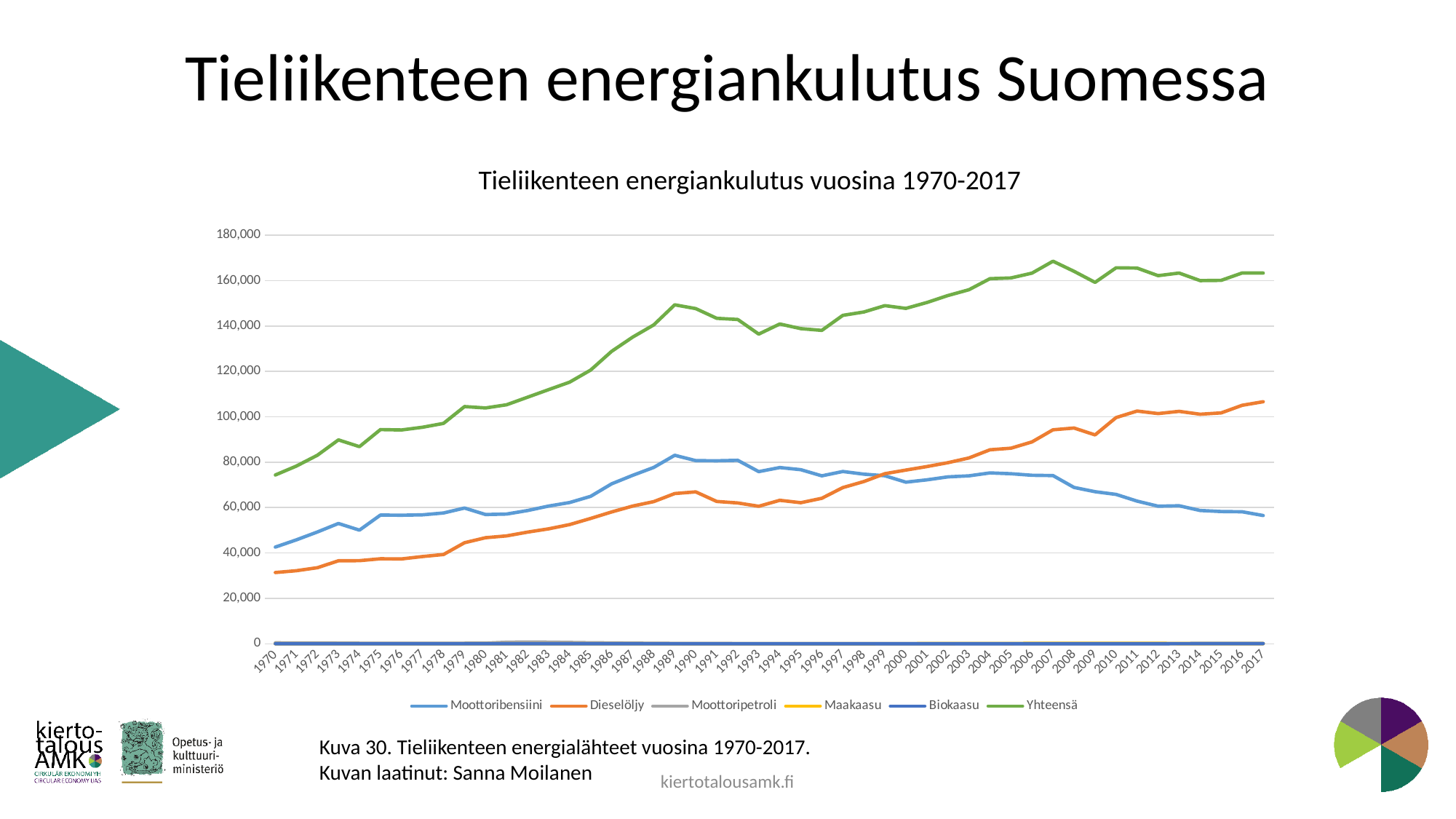
Which series has the highest values throughout the chart? Yhteensä How many series does the legend list? 6 What kind of chart is shown on the slide? line chart Is the value for Moottoribensiini in 2017 greater or less than 60,000? less Is the value for Yhteensä in 1970 greater or less than 80,000? less Does the Dieselöljy series generally rise or fall from 1970 to 2017? rise Is the value for Dieselöljy in 2017 greater or less than 100,000? greater What is the title of the chart? Tieliikenteen energiankulutus vuosina 1970-2017 In 2017, which is larger: Dieselöljy or Moottoribensiini? Dieselöljy How many years are plotted along the x axis? 48 In 1970, which is larger: Moottoribensiini or Dieselöljy? Moottoribensiini